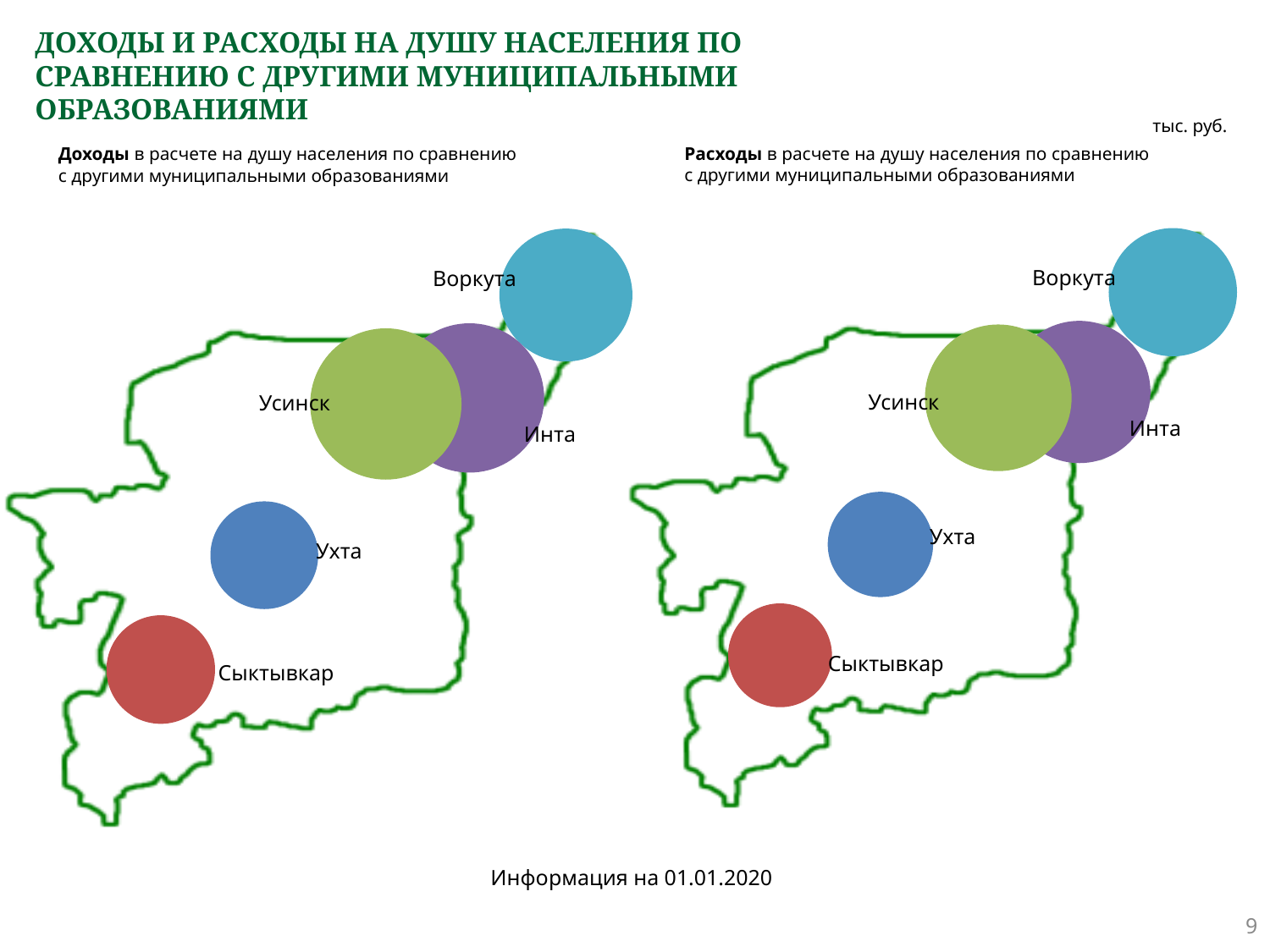
On the left chart (Доходы), which municipality has the largest bubble? Усинск On the left chart (Доходы), which bubble is larger: Усинск or Ухта? Усинск What unit of measurement is indicated for the charts on the slide? тыс. руб. How many municipalities are shown as bubbles on the left chart (Доходы)? 5 What kind of chart is used on the left (Доходы) side of the slide? Bubble chart How many municipalities are shown as bubbles on the right chart (Расходы)? 5 On the right chart (Расходы), which municipality has the largest bubble? Усинск On the right chart (Расходы), which bubble is larger: Воркута or Ухта? Воркута What colour is the bubble for Сыктывкар on the charts? Red On the left chart (Доходы), which bubble is larger: Инта or Ухта? Инта